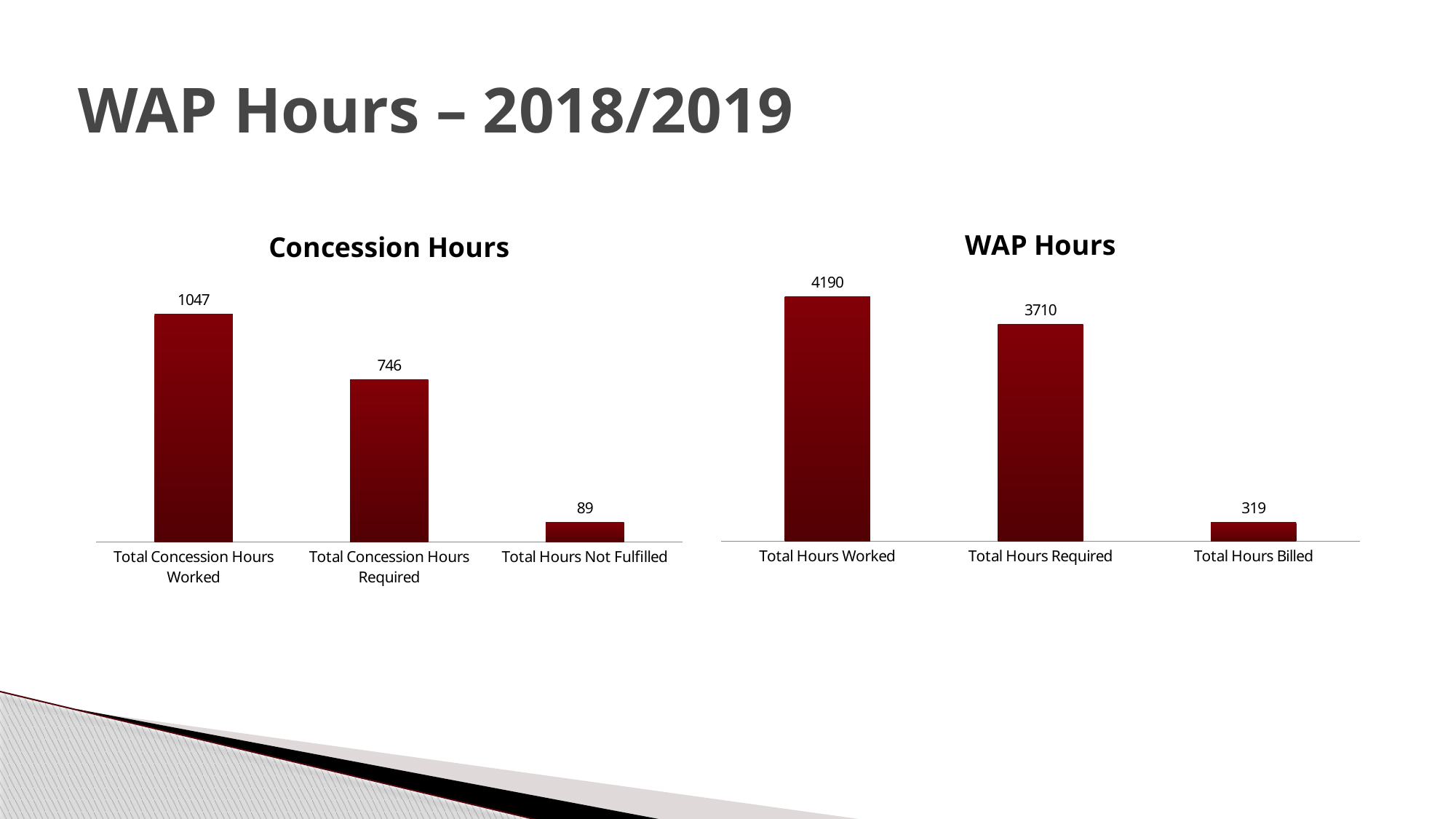
In the Concession Hours chart, what is the value for Total Hours Not Fulfilled? 89 What is the title of the chart on the left side of the slide? Concession Hours In the WAP Hours chart, which is larger: Total Hours Worked or Total Hours Required? Total Hours Worked In the Concession Hours chart, what is the difference between Total Concession Hours Worked and Total Concession Hours Required? 301 In the WAP Hours chart, what is the value for Total Hours Billed? 319 How many categories are shown in the Concession Hours chart? 3 What kind of chart is the WAP Hours chart? Bar chart In the WAP Hours chart, what is the difference between Total Hours Worked and Total Hours Required? 480 In the Concession Hours chart, which category has the highest value? Total Concession Hours Worked In the WAP Hours chart, which category has the lowest value? Total Hours Billed In the Concession Hours chart, what is the value for Total Concession Hours Worked? 1047 In the WAP Hours chart, what is the value for Total Hours Required? 3710